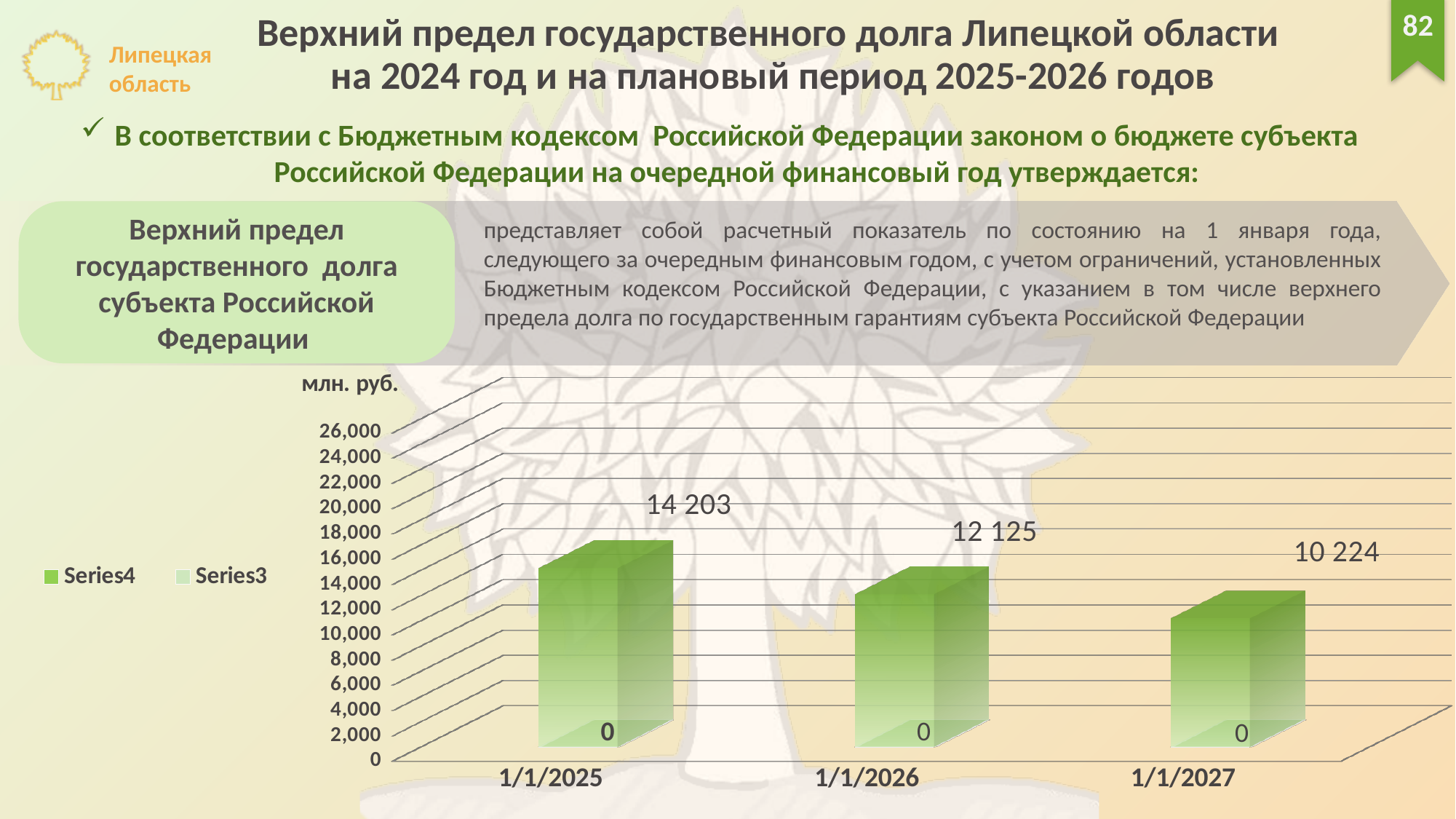
What is the difference between the values for 1/1/2026 and 1/1/2027? 1 901 What is the value shown for 1/1/2026? 12 125 Do the values rise or fall from 1/1/2025 to 1/1/2027? fall What is the difference between the values for 1/1/2025 and 1/1/2026? 2 078 What kind of chart is shown? bar chart Which date has the highest value? 1/1/2025 What is the value shown for 1/1/2025? 14 203 What is the value shown for 1/1/2027? 10 224 How many dates are shown on the x axis? 3 How many series does the legend list? 2 Which is larger, the value for 1/1/2025 or the value for 1/1/2027? 1/1/2025 Which date has the lowest value? 1/1/2027